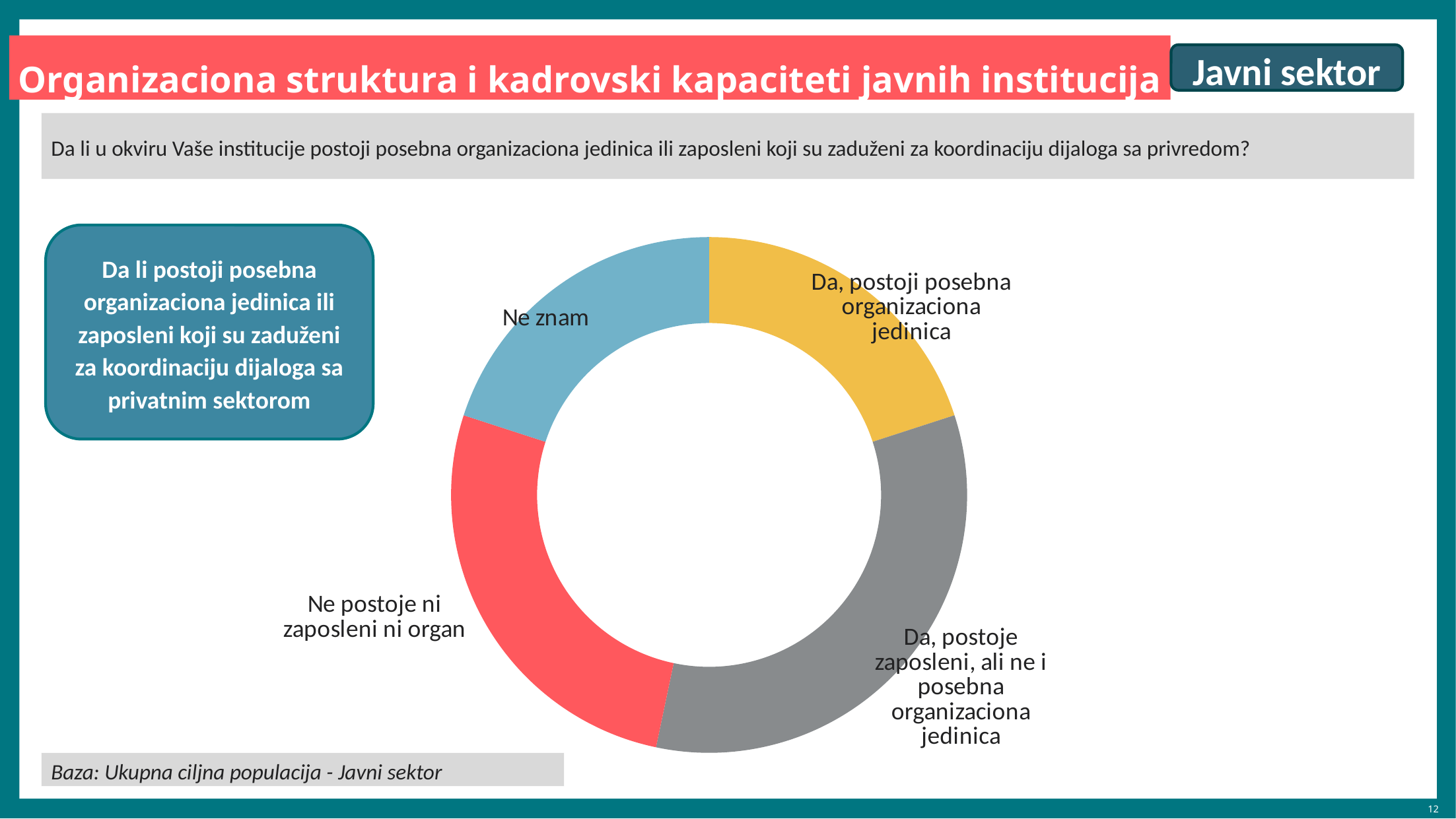
Which slice is larger: "Da, postoje zaposleni, ali ne i posebna organizaciona jedinica" or "Da, postoji posebna organizaciona jedinica"? Da, postoje zaposleni, ali ne i posebna organizaciona jedinica Which slice is larger: "Da, postoje zaposleni, ali ne i posebna organizaciona jedinica" or "Ne postoje ni zaposleni ni organ"? Da, postoje zaposleni, ali ne i posebna organizaciona jedinica Which category has the largest slice in the donut chart? Da, postoje zaposleni, ali ne i posebna organizaciona jedinica What colour is the "Ne znam" slice of the donut chart? Light blue Which slice is larger: "Ne postoje ni zaposleni ni organ" or "Ne znam"? Ne postoje ni zaposleni ni organ What colour is the "Da, postoji posebna organizaciona jedinica" slice of the donut chart? Yellow What kind of chart is shown on the slide? Pie chart (donut) How many categories (slices) does the donut chart have? 4